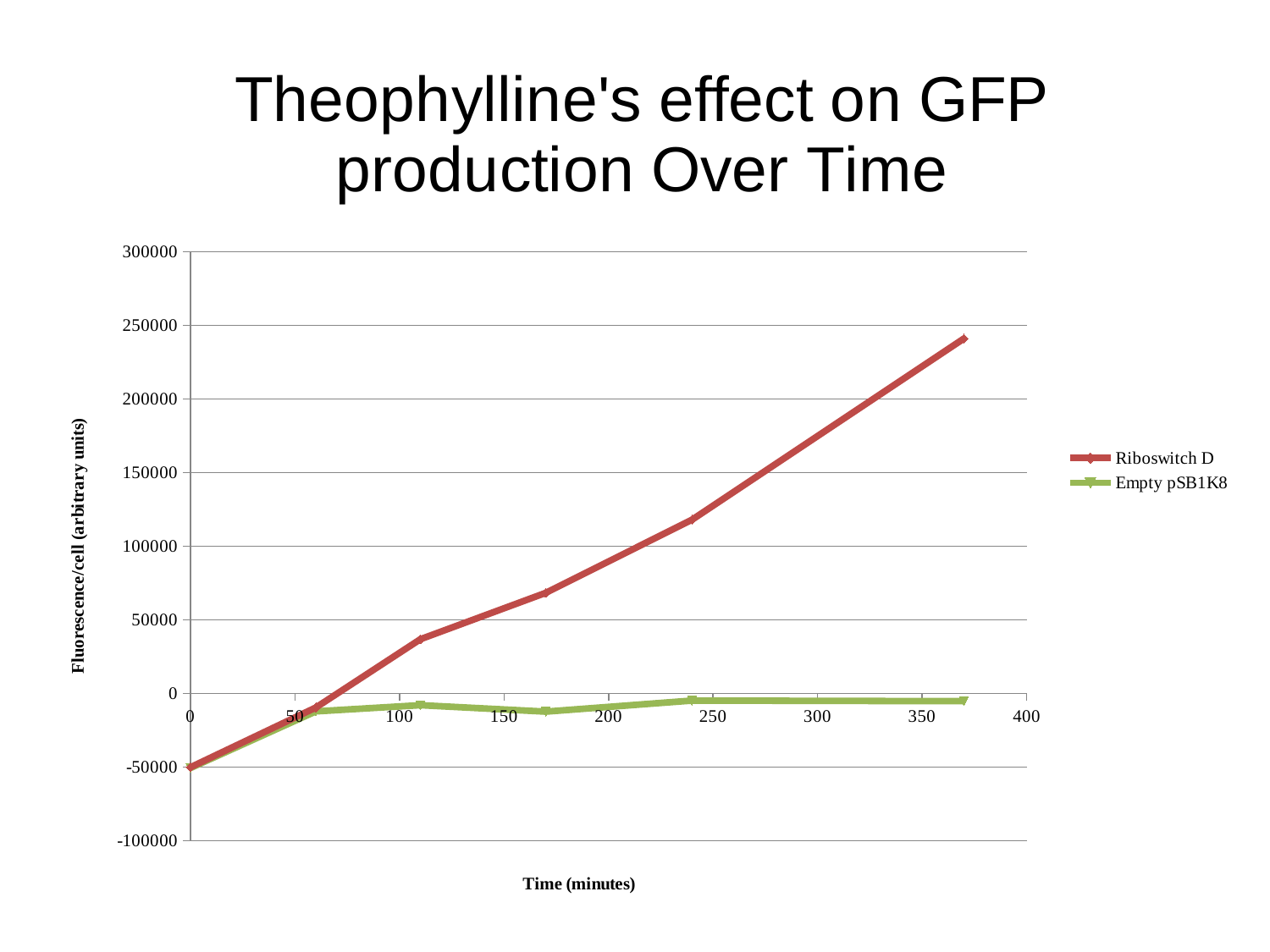
What is the title of the chart? Theophylline's effect on GFP production Over Time Is the value for Empty pSB1K8 at the final time point (around 370 minutes) greater or less than 50000? less How many series does the legend list? 2 Which series has the higher value at the final time point, Riboswitch D or Empty pSB1K8? Riboswitch D Is the value for Riboswitch D at the final time point (around 370 minutes) greater or less than 200000? greater Is the value for Riboswitch D at around 110 minutes greater or less than 50000? less What is the label of the x axis? Time (minutes) What kind of chart is shown on the slide? line chart Does the Riboswitch D line rise or fall as time increases? rise Which series reaches the highest value on the chart? Riboswitch D